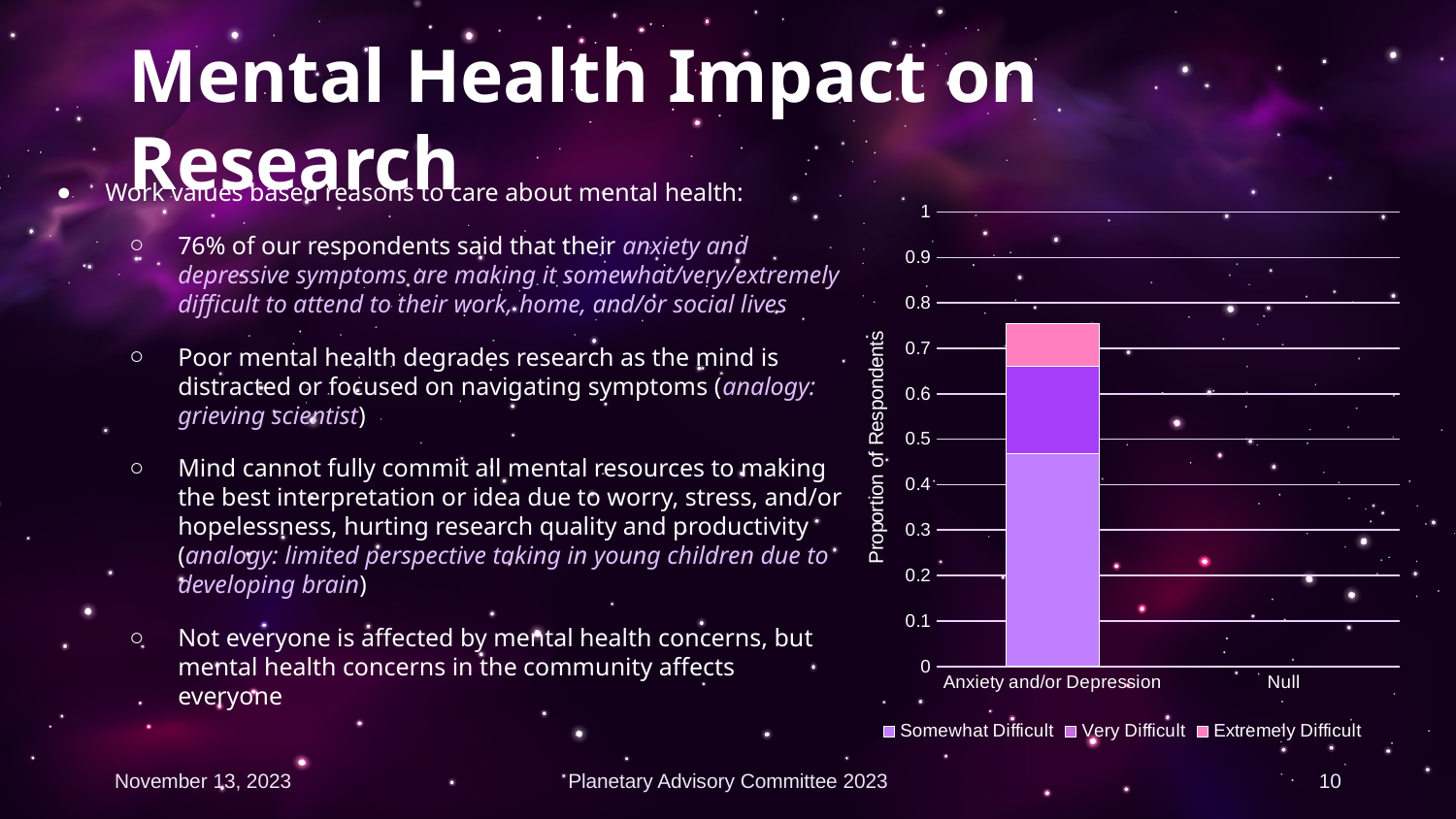
Which category has the taller stacked bar, Anxiety and/or Depression or Null? Anxiety and/or Depression Is the total height of the stacked bar for Anxiety and/or Depression greater or less than 0.7? greater What is the label on the y axis of the chart? Proportion of Respondents How many series does the chart legend list? 3 Is the total height of the stacked bar for Anxiety and/or Depression greater or less than 0.8? less Which series has the smallest segment in the Anxiety and/or Depression bar? Extremely Difficult Which series has the largest segment in the Anxiety and/or Depression bar? Somewhat Difficult Is the Somewhat Difficult segment of the Anxiety and/or Depression bar greater or less than 0.5? less What are the three series listed in the chart legend? Somewhat Difficult, Very Difficult, Extremely Difficult How many categories are shown on the x axis of the chart? 2 What kind of chart is shown on the slide? Stacked bar chart